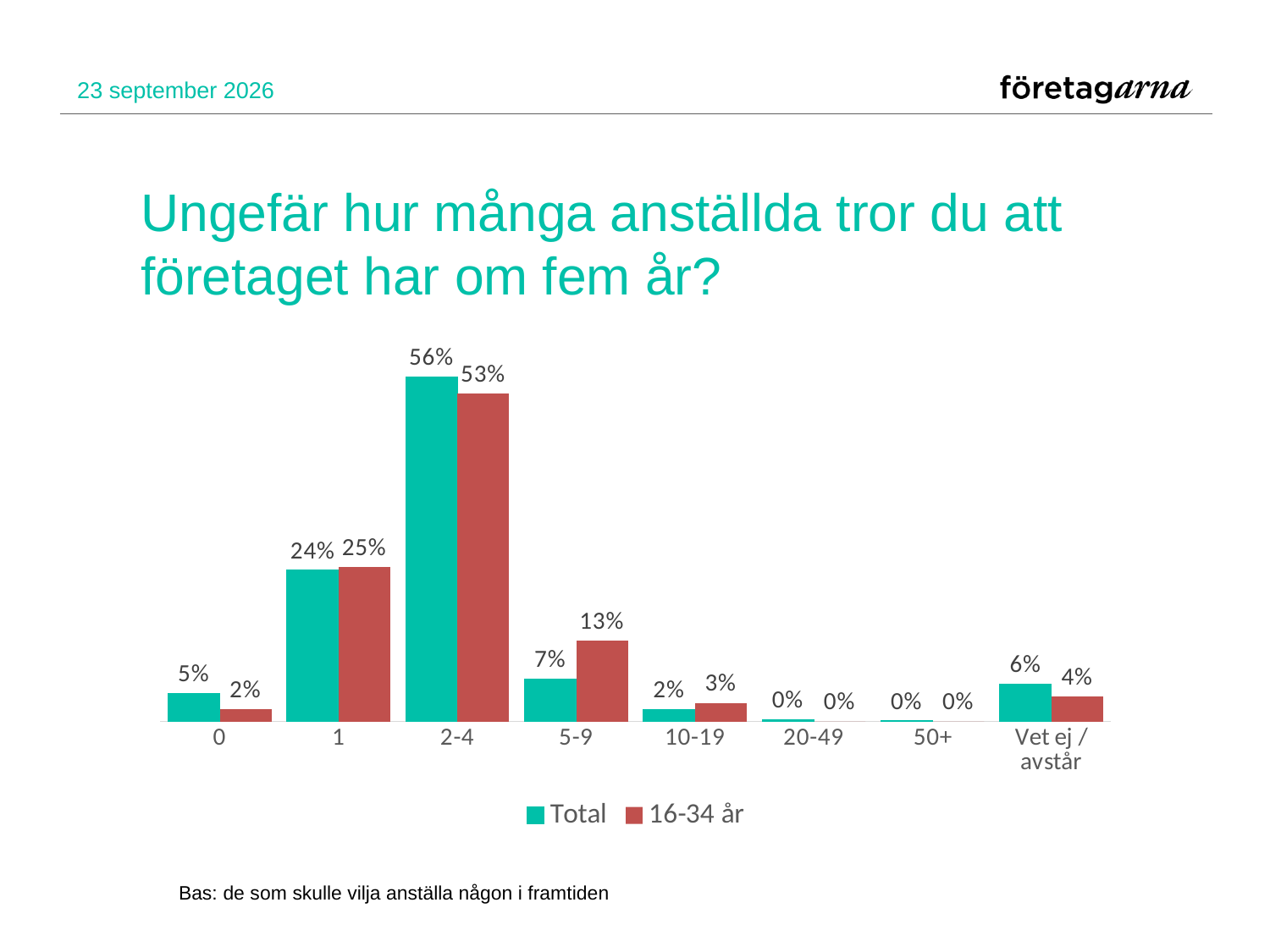
Which is larger in the 1 category, Total or 16-34 år? 16-34 år Which is larger in the 0 category, Total or 16-34 år? Total Which series is shown in red in the legend? 16-34 år How many series does the legend list? 2 What is the value for Total in the Vet ej / avstår category? 6% How many categories are shown on the x axis? 8 What is the difference between the Total values for the 2-4 and 1 categories? 32% What is the difference between the Total and 16-34 år values in the 5-9 category? 6% What kind of chart is shown on the slide? Bar chart What is the value for Total in the 2-4 category? 56% Which category has the highest value for the Total series? 2-4 What is the value for 16-34 år in the 5-9 category? 13%